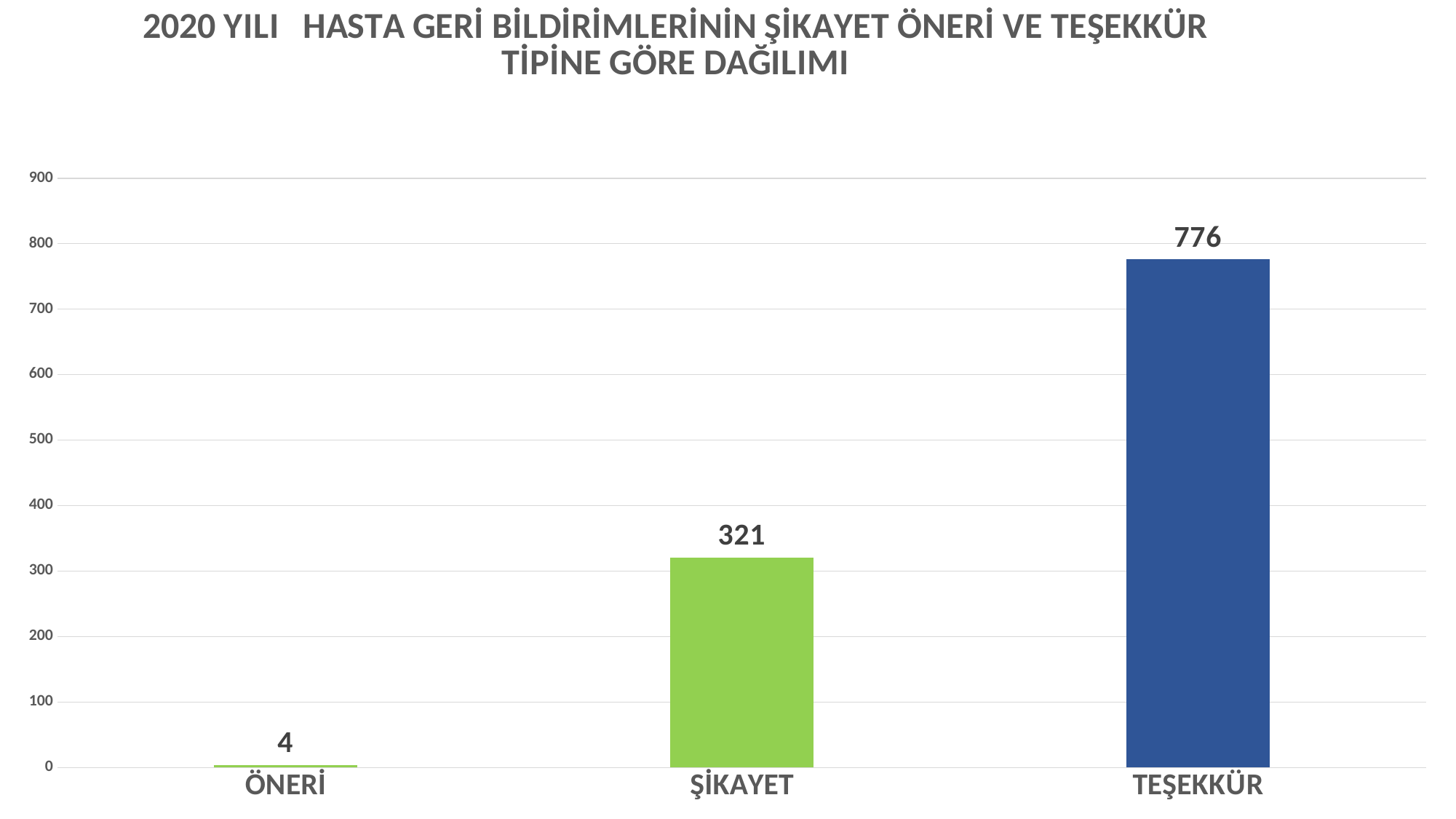
What is the value for ÖNERİ? 4 Which category has the highest value? TEŞEKKÜR What is the value for TEŞEKKÜR? 776 How many categories are shown on the x axis? 3 Is the value for TEŞEKKÜR greater or less than 700? greater What is the difference between the values for ŞİKAYET and ÖNERİ? 317 What is the value for ŞİKAYET? 321 Do the values rise or fall from left to right along the x axis? rise What is the difference between the values for TEŞEKKÜR and ŞİKAYET? 455 Which is larger, the value for ŞİKAYET or the value for TEŞEKKÜR? TEŞEKKÜR Which category has the lowest value? ÖNERİ What kind of chart is shown on the slide? bar chart